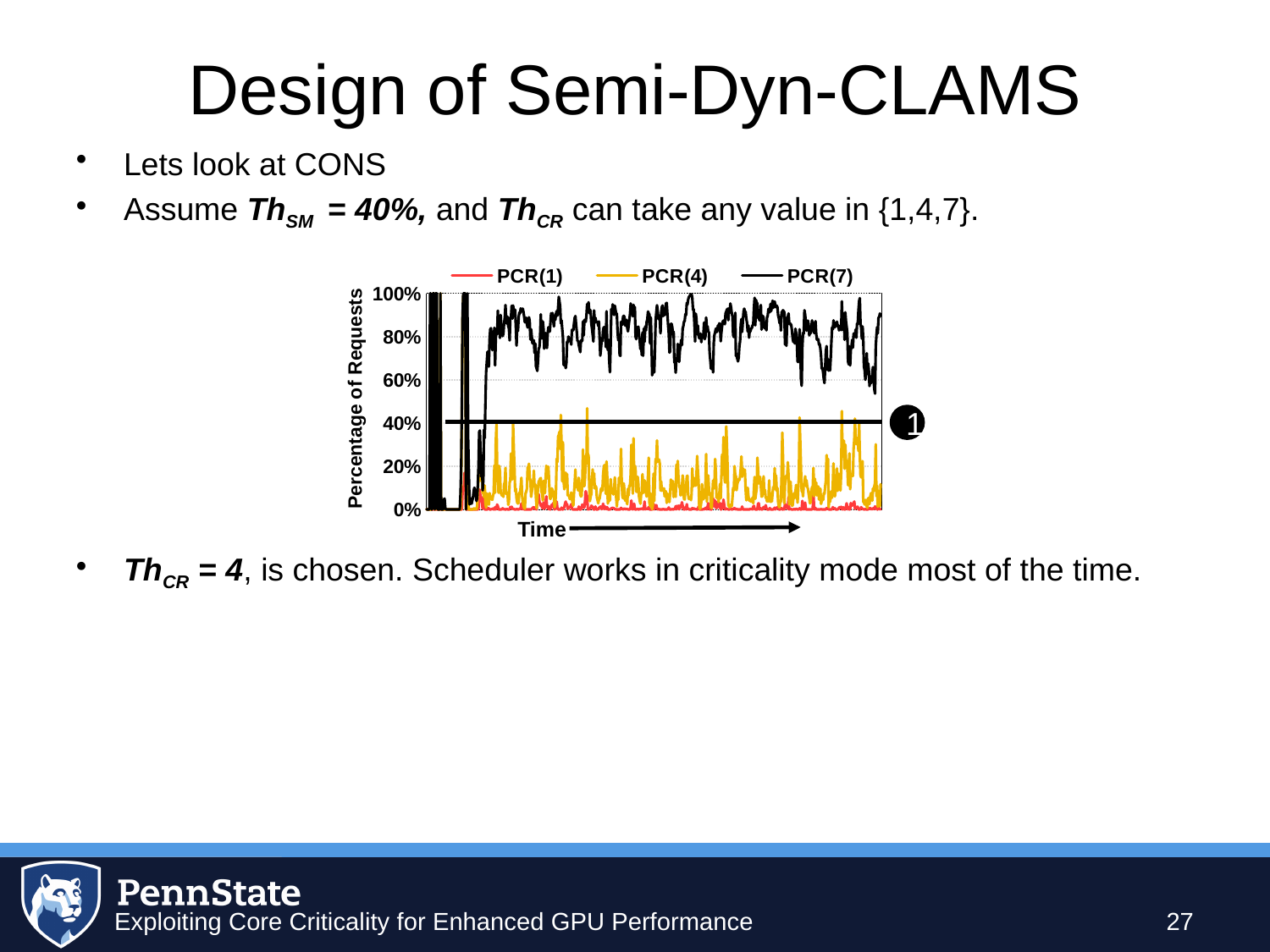
What kind of chart is shown on the slide? line chart Which series is larger for most of the time shown, PCR(4) or PCR(7)? PCR(7) At what percentage level is the thick horizontal line drawn across the chart? 40% For most of the time shown, is the value of PCR(1) greater or less than 20%? less What are the three series named in the chart's legend? PCR(1), PCR(4), PCR(7) What is the highest tick value shown on the chart's vertical axis? 100% How many series does the chart's legend list? 3 For most of the time shown, is the value of PCR(7) greater or less than 60%? greater What is the label of the chart's vertical axis? Percentage of Requests Which series stays highest for most of the time shown in the chart? PCR(7) For most of the time shown, is the value of PCR(4) greater or less than 40%? less Which series stays lowest for most of the time shown in the chart? PCR(1)